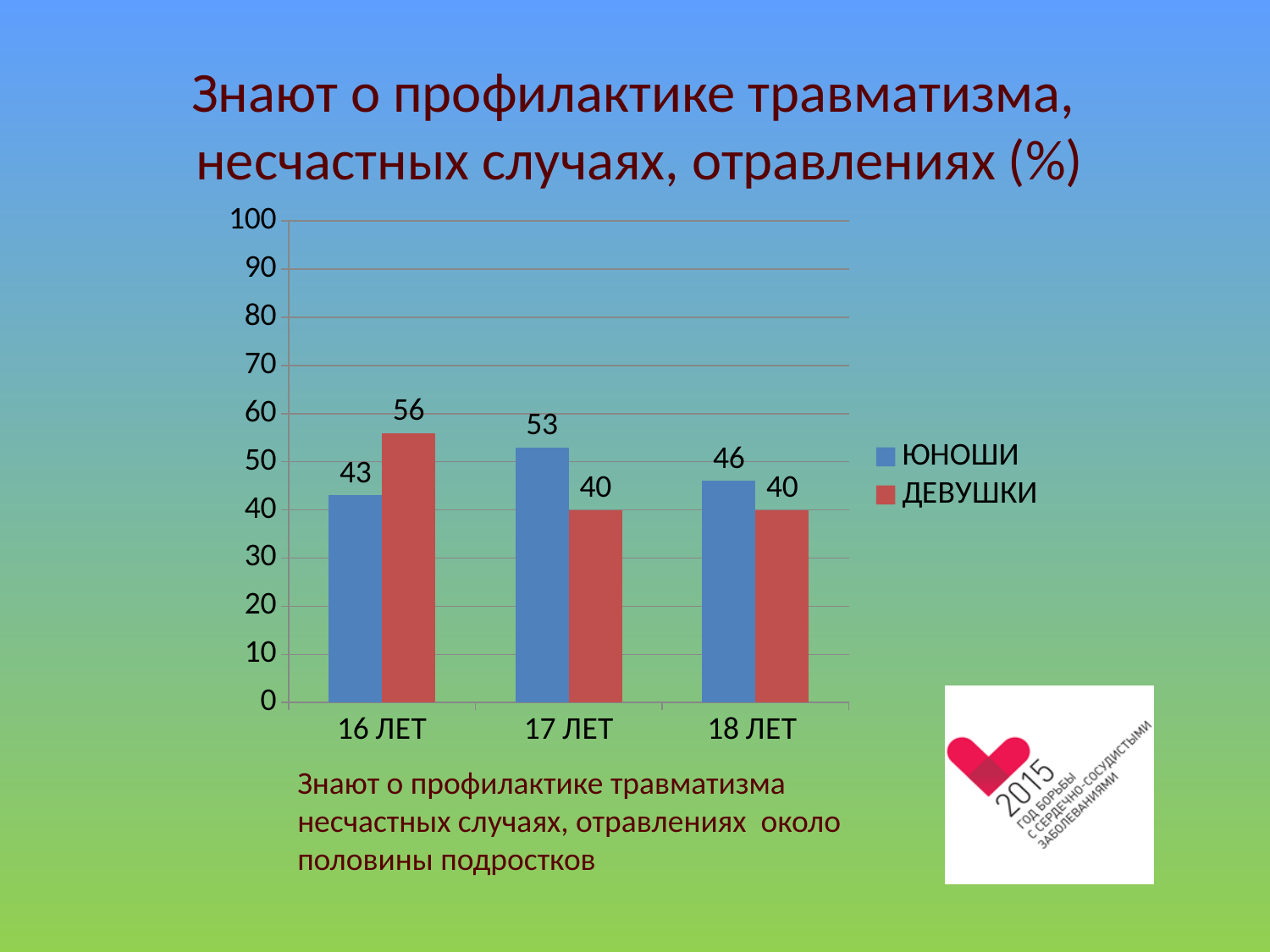
At 17 ЛЕТ, which is larger: ЮНОШИ or ДЕВУШКИ? ЮНОШИ Which age group has the highest value for ЮНОШИ? 17 ЛЕТ What kind of chart is shown on the slide? bar chart How many series does the legend list? 2 Which colour represents ДЕВУШКИ in the chart? red What is the value for ЮНОШИ at 16 ЛЕТ? 43 Which age group has the lowest value for ЮНОШИ? 16 ЛЕТ What is the value for ДЕВУШКИ at 16 ЛЕТ? 56 How many age categories are shown on the x axis? 3 What is the value for ЮНОШИ at 17 ЛЕТ? 53 What is the difference between ДЕВУШКИ and ЮНОШИ at 16 ЛЕТ? 13 What is the value for ДЕВУШКИ at 18 ЛЕТ? 40